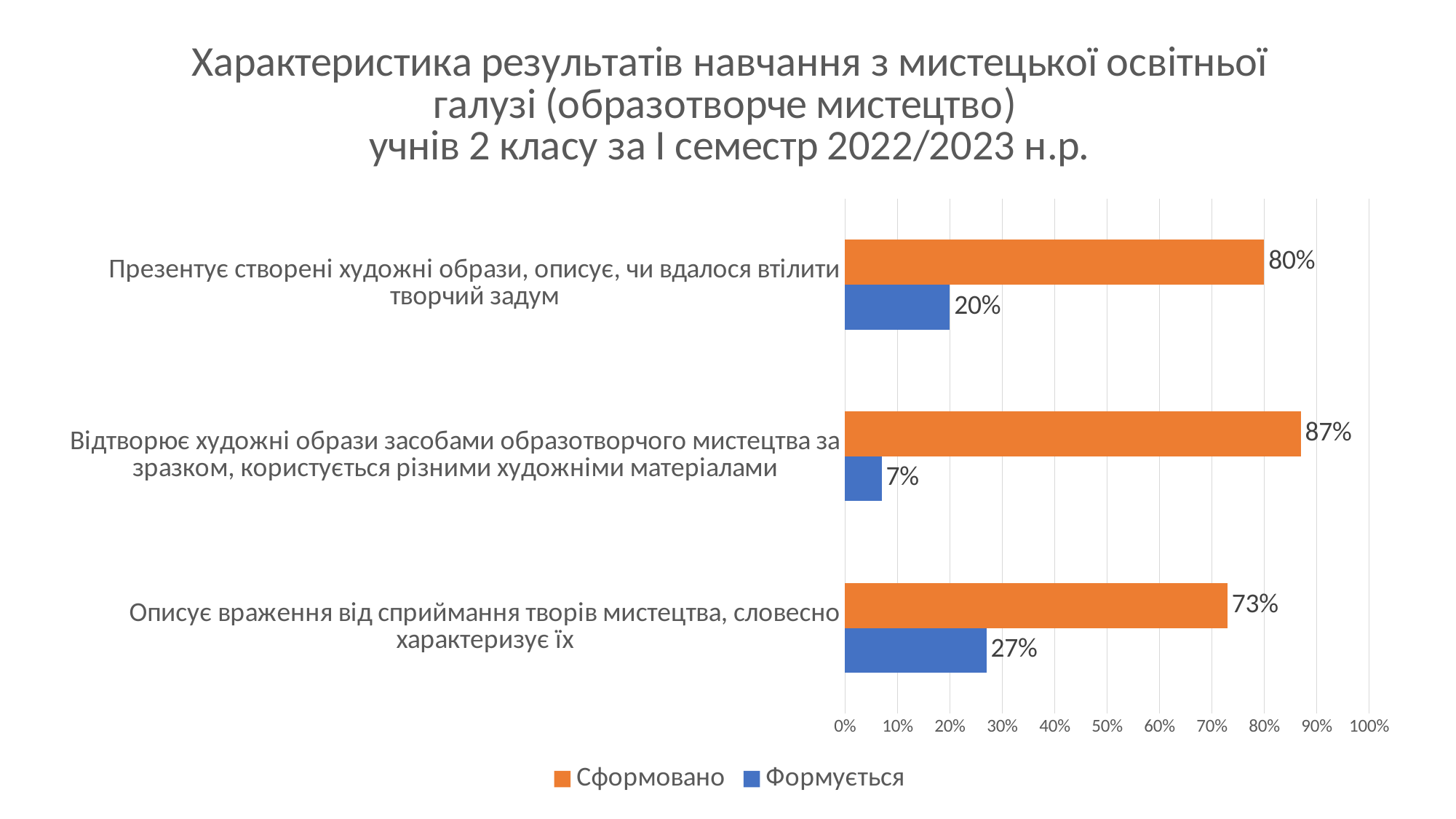
What is the difference between the 'Сформовано' and 'Формується' values for 'Описує враження від сприймання творів мистецтва, словесно характеризує їх'? 46% How many categories are shown on the chart? 3 How many series does the legend list? 2 Which category has the lowest 'Формується' value? Відтворює художні образи засобами образотворчого мистецтва за зразком, користується різними художніми матеріалами What is the 'Сформовано' value for 'Презентує створені художні образи, описує, чи вдалося втілити творчий задум'? 80% Which colour represents the 'Формується' series? Blue What kind of chart is shown on the slide? Bar chart Which category has the highest 'Сформовано' value? Відтворює художні образи засобами образотворчого мистецтва за зразком, користується різними художніми матеріалами What is the 'Формується' value for 'Описує враження від сприймання творів мистецтва, словесно характеризує їх'? 27% Is the 'Сформовано' value for 'Описує враження від сприймання творів мистецтва, словесно характеризує їх' greater or less than 60%? greater Which is larger: the 'Формується' value for 'Презентує створені художні образи, описує, чи вдалося втілити творчий задум' or for 'Описує враження від сприймання творів мистецтва, словесно характеризує їх'? Описує враження від сприймання творів мистецтва, словесно характеризує їх What is the 'Формується' value for 'Відтворює художні образи засобами образотворчого мистецтва за зразком, користується різними художніми матеріалами'? 7%